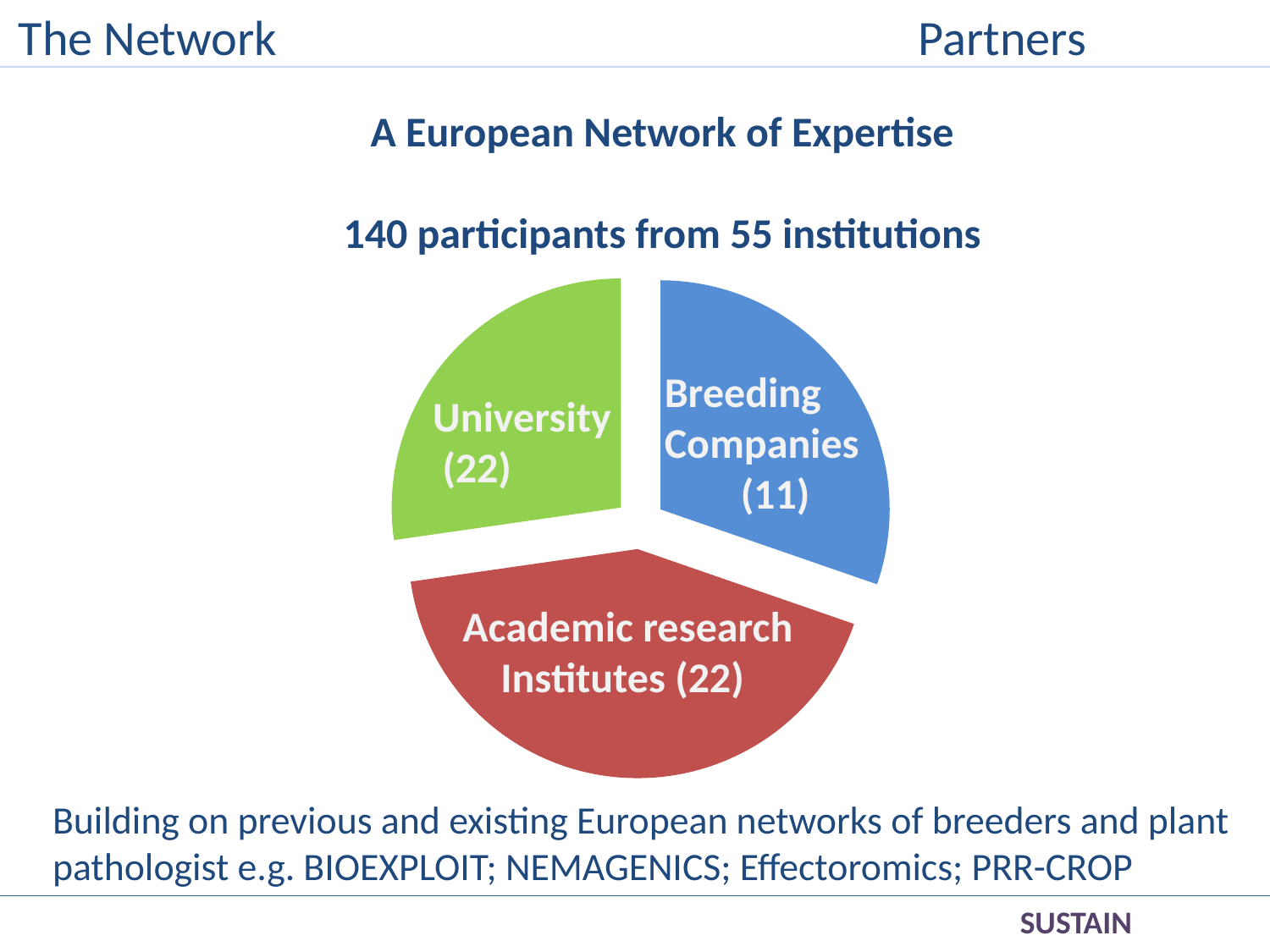
How many institutions are in the University category? 22 How many institutions are in the Academic research Institutes category? 22 How many categories does the pie chart show? 3 What is the total number of institutions across all slices of the pie chart? 55 Which category has the fewest institutions? Breeding Companies Which has more institutions, University or Breeding Companies? University What is the difference between the number of University institutions and Breeding Companies? 11 What kind of chart is shown on the slide? Pie chart What colour is the University slice? Green What share of the pie does University represent? 40% What share of the pie does Breeding Companies represent? 20% How many institutions are in the Breeding Companies category? 11